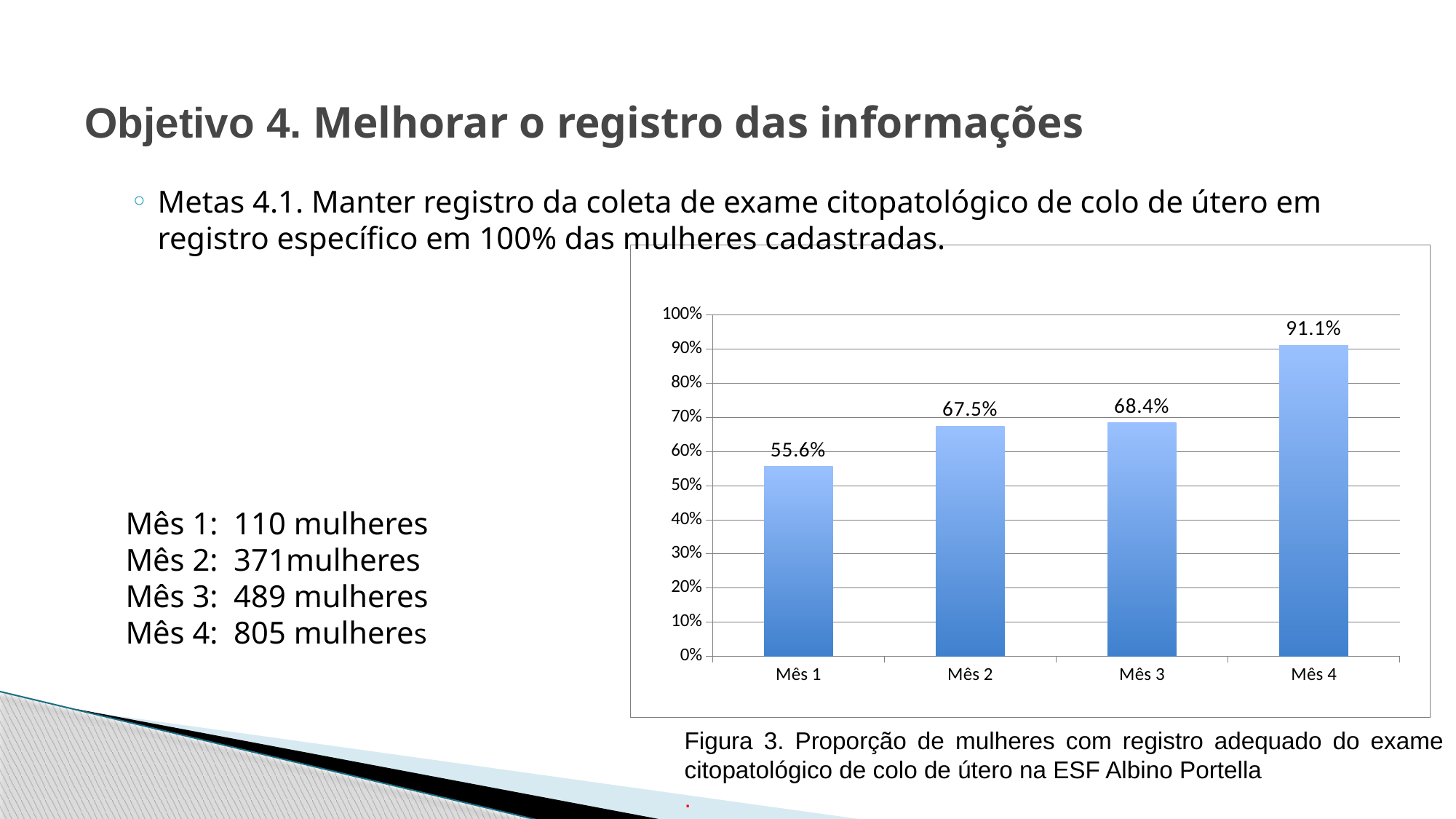
What is the value for Mês 4? 91.1% Is the value for Mês 3 greater or less than 60%? greater What is the value for Mês 2? 67.5% Which month has the highest value? Mês 4 Which is larger, the value for Mês 2 or the value for Mês 4? Mês 4 What is the difference between the values for Mês 4 and Mês 1? 35.5% What is the value for Mês 1? 55.6% Do the values rise or fall from Mês 1 to Mês 4? rise Which month has the lowest value? Mês 1 What kind of chart is shown on the slide? bar chart How many months are shown on the x axis? 4 What is the difference between the values for Mês 3 and Mês 2? 0.9%